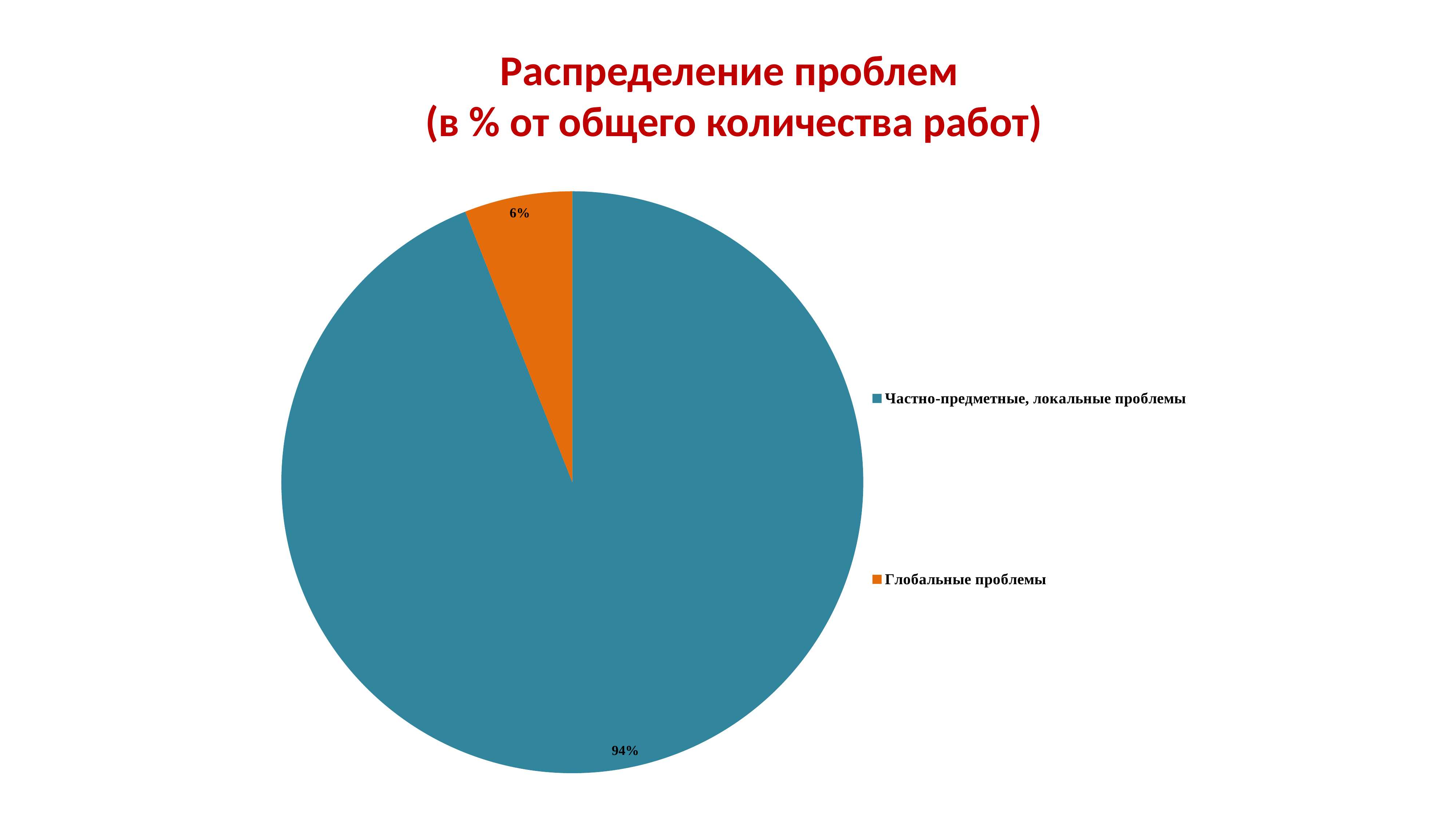
What colour is the slice for Глобальные проблемы? orange What percentage is shown for Частно-предметные, локальные проблемы? 94% What is the title of the slide? Распределение проблем (в % от общего количества работ) How many entries does the legend list? 2 Which category has the smallest share of the pie? Глобальные проблемы What percentage is shown for Глобальные проблемы? 6% What share of the pie does the Глобальные проблемы slice represent? 6% Which is larger: the share for Глобальные проблемы or the share for Частно-предметные, локальные проблемы? Частно-предметные, локальные проблемы What type of chart is shown on the slide? pie chart Which category has the largest share of the pie? Частно-предметные, локальные проблемы How many slices does the pie chart have? 2 What is the difference in percentage points between Частно-предметные, локальные проблемы and Глобальные проблемы? 88